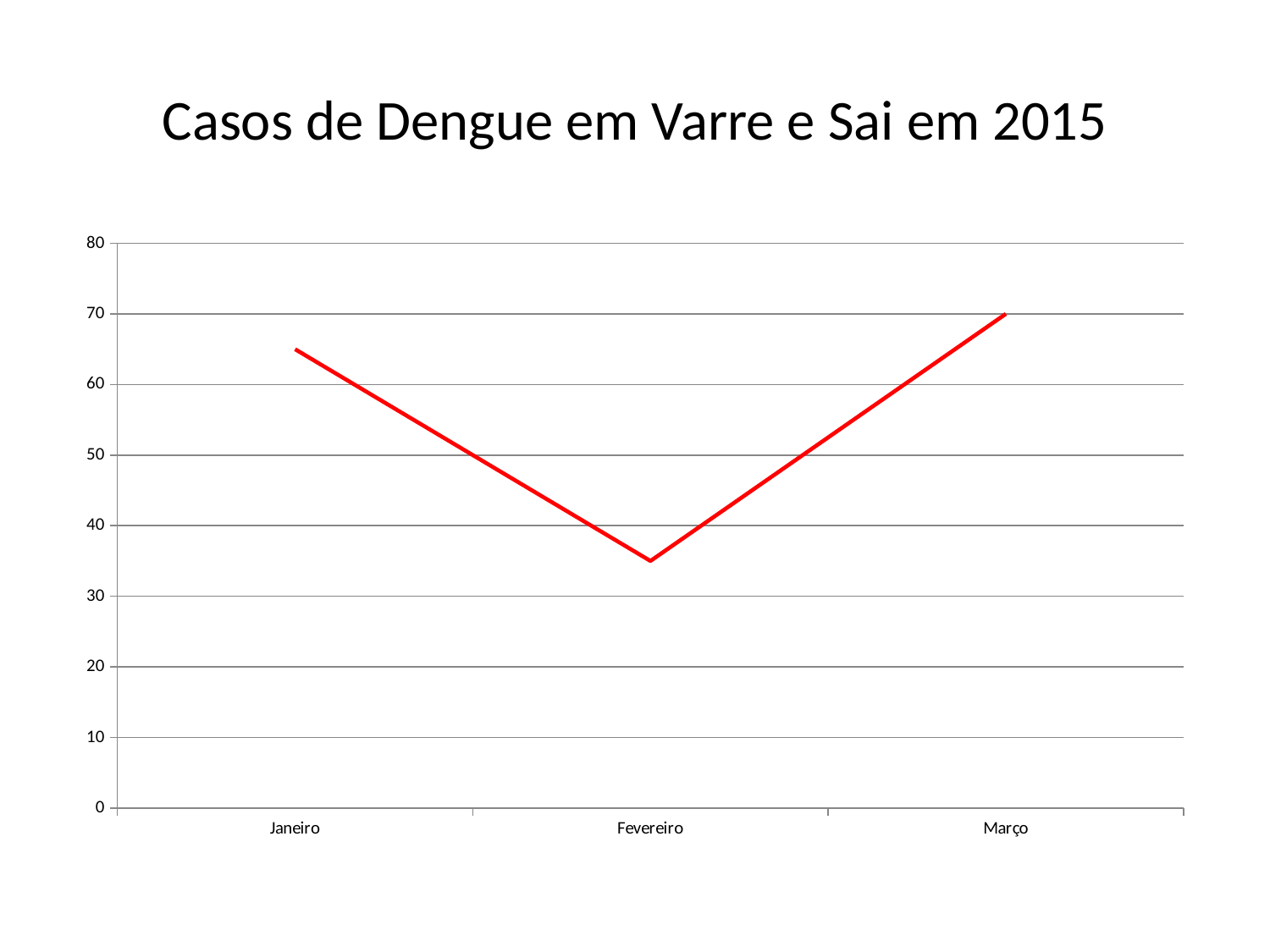
What is the value for Março? 70 How many months are plotted on the x axis? 3 Which month has the lowest number of dengue cases? Fevereiro Which is larger, the value for Janeiro or the value for Fevereiro? Janeiro Is the value for Janeiro greater or less than 70? less Is the value for Fevereiro greater or less than 40? less What kind of chart is shown on the slide? line chart Which is larger, the value for Março or the value for Janeiro? Março Do the values rise or fall from Janeiro to Fevereiro? fall What is the title of the slide? Casos de Dengue em Varre e Sai em 2015 Is the value for Janeiro greater or less than 60? greater Which month has the highest number of dengue cases? Março